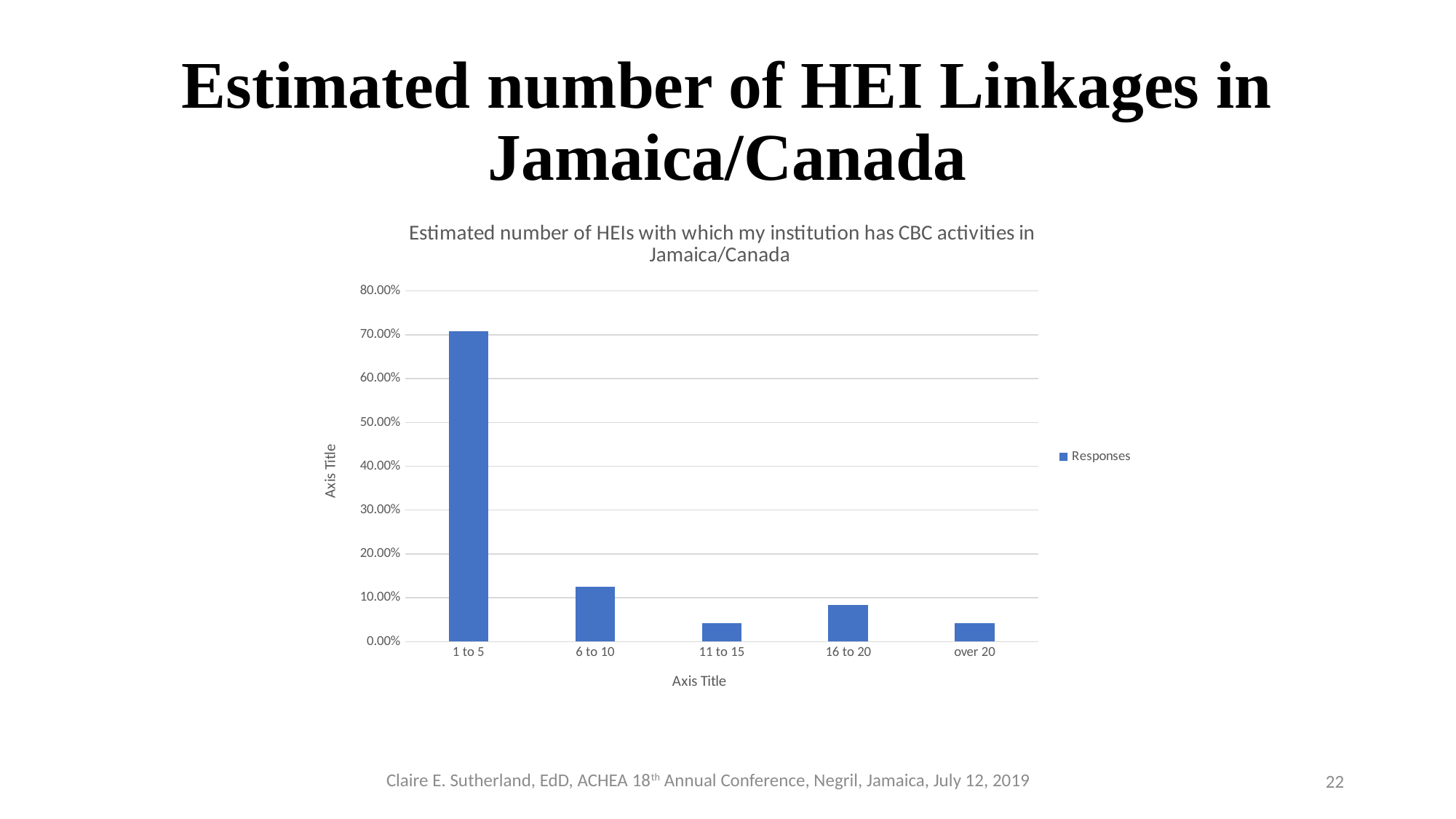
Is the value for 16 to 20 greater or less than 10.00%? less Is the value for 6 to 10 greater or less than 10.00%? greater Is the value for 1 to 5 greater or less than 60.00%? greater Which is larger, the value for 1 to 5 or the value for 6 to 10? 1 to 5 How many categories are shown on the x axis of the chart? 5 What type of chart is shown on the slide? bar chart Which category has the highest value in the chart? 1 to 5 How many series does the chart legend list? 1 Which is larger, the value for 6 to 10 or the value for 16 to 20? 6 to 10 What is the title of the chart? Estimated number of HEIs with which my institution has CBC activities in Jamaica/Canada What is the name of the series shown in the chart legend? Responses